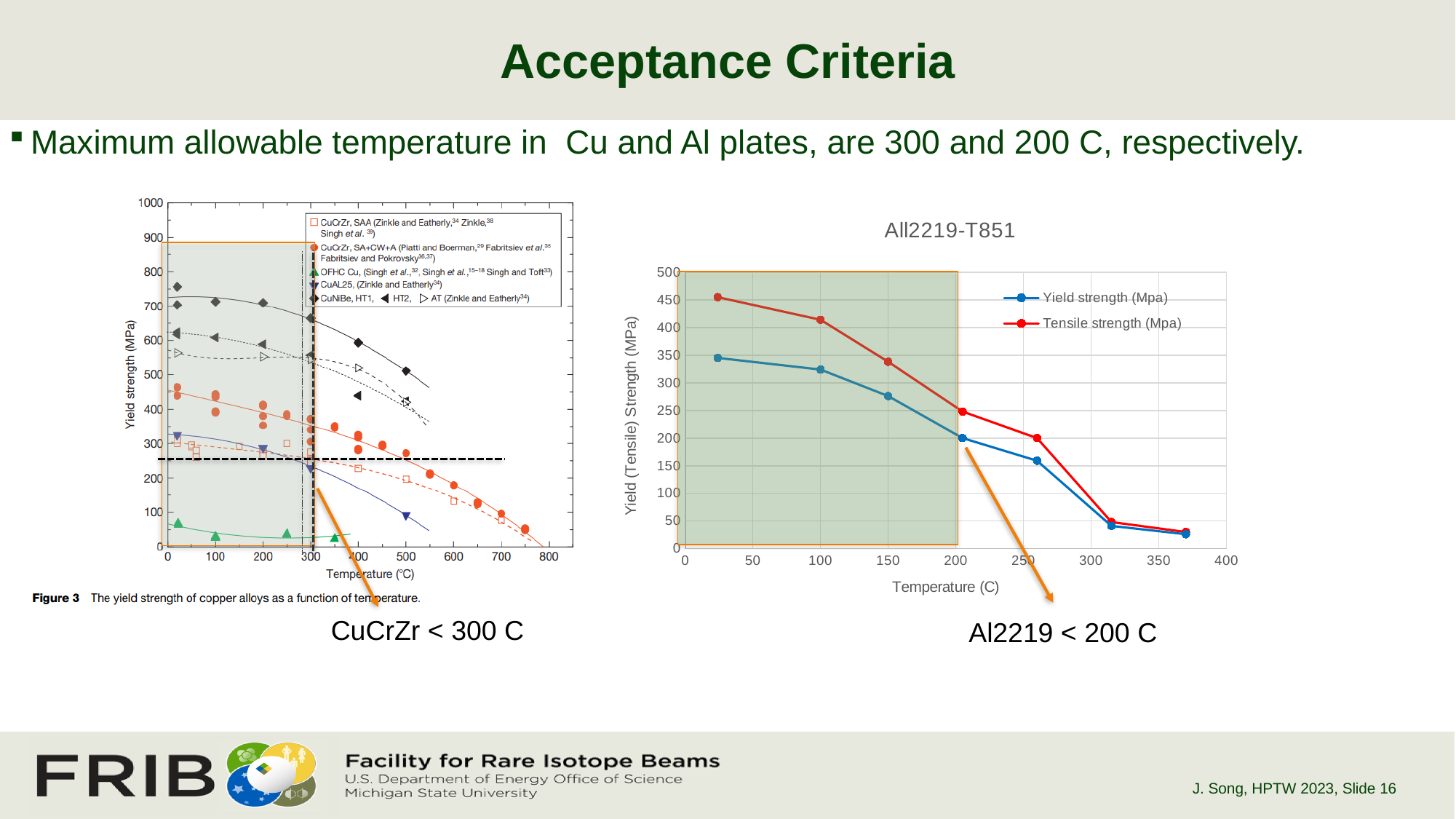
In the All2219-T851 chart, how many data points are plotted for the Tensile strength series? 7 In the All2219-T851 chart, do the strength values rise or fall as temperature increases? fall In the All2219-T851 chart, is the yield strength at about 260 C greater or less than 200? less What is the x-axis title of the All2219-T851 chart? Temperature (C) In the All2219-T851 chart, which is larger at 100 C, the yield strength or the tensile strength? Tensile strength What kind of chart is the All2219-T851 chart on the right? line chart In the All2219-T851 chart, is the yield strength at about 315 C greater or less than 100? less In the All2219-T851 chart, is the yield strength at 100 C greater or less than 300? greater How many series does the legend of the All2219-T851 chart list? 2 In the Figure 3 chart on the left, which alloy has the lowest yield strength across the plotted temperatures? OFHC Cu